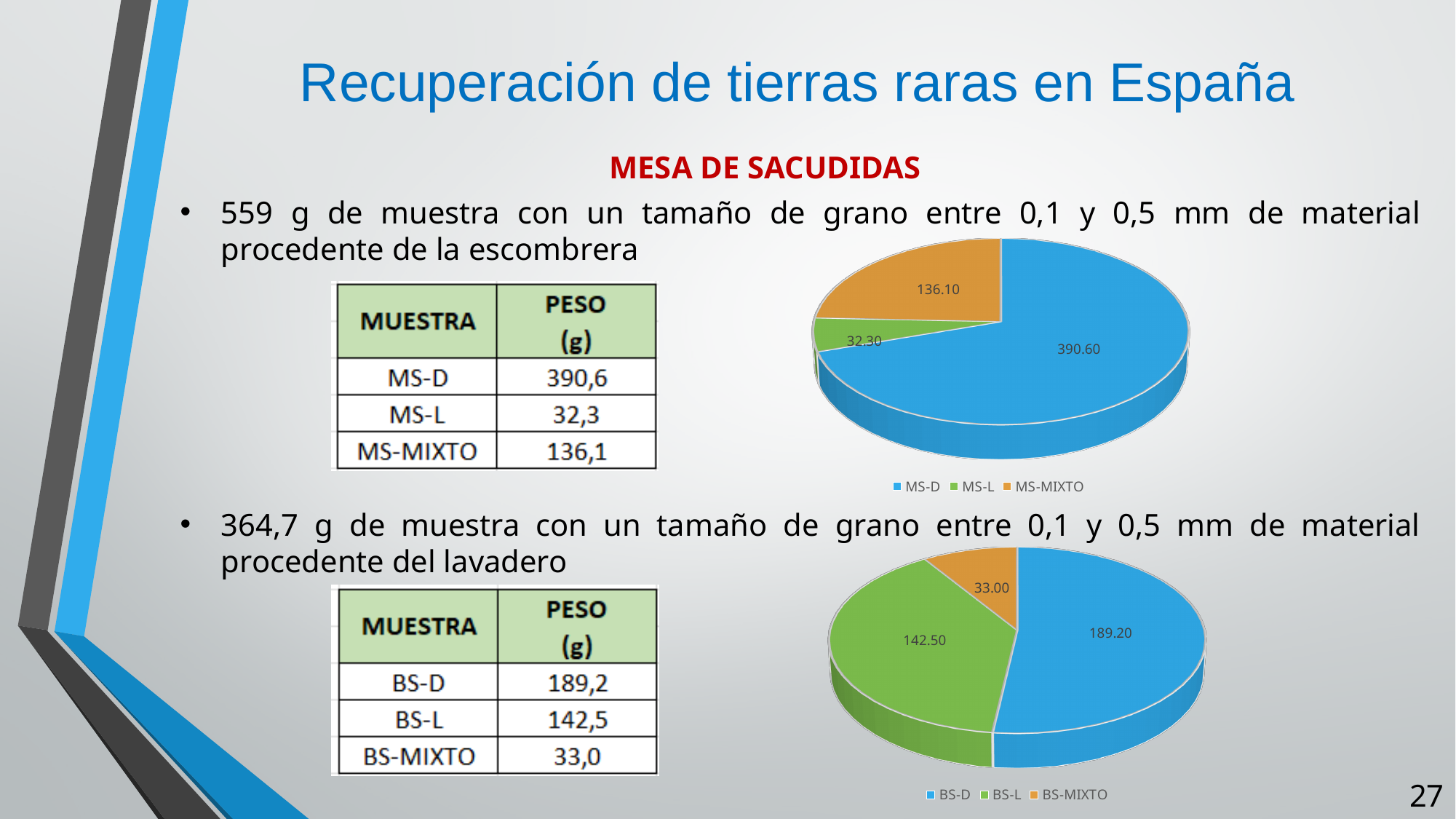
In the bottom pie chart, what is the value for BS-L? 142.50 How many categories does the legend of the bottom pie chart list? 3 In the bottom pie chart, what is the total of all three slices? 364.70 In the top pie chart, which category has the largest slice? MS-D In the top pie chart, what is the value for MS-D? 390.60 In the top pie chart, what is the value for MS-MIXTO? 136.10 In the top pie chart, what is the difference between the values for MS-D and MS-MIXTO? 254.50 In the bottom pie chart, which is larger, BS-D or BS-L? BS-D In the top pie chart, what is the value for MS-L? 32.30 What kind of chart is the top chart on the slide? Pie chart In the bottom pie chart, what is the value for BS-MIXTO? 33.00 In the top pie chart, which category has the smallest slice? MS-L